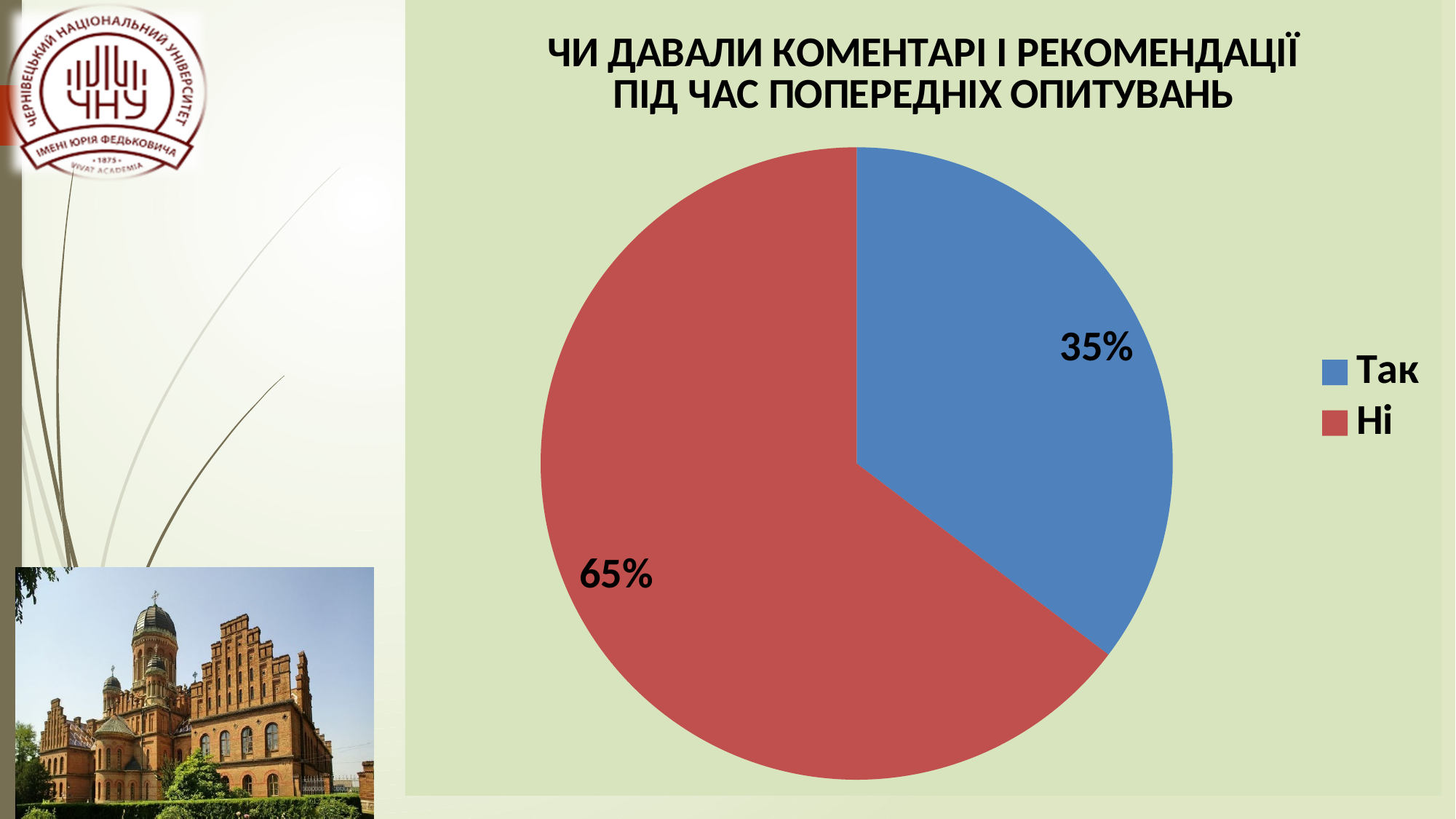
What is the difference in percentage points between the "Ні" and "Так" slices? 30 How many entries does the legend list? 2 What kind of chart is shown on the slide? pie chart Which category has the smallest slice of the pie? Так What share of the pie does the "Ні" slice represent? 65% What colour is the "Так" slice? blue What share of the pie does the "Так" slice represent? 35% What colour is the "Ні" slice? red How many slices does the pie chart have? 2 Which is larger, the "Так" slice or the "Ні" slice? Ні Which category has the largest slice of the pie? Ні